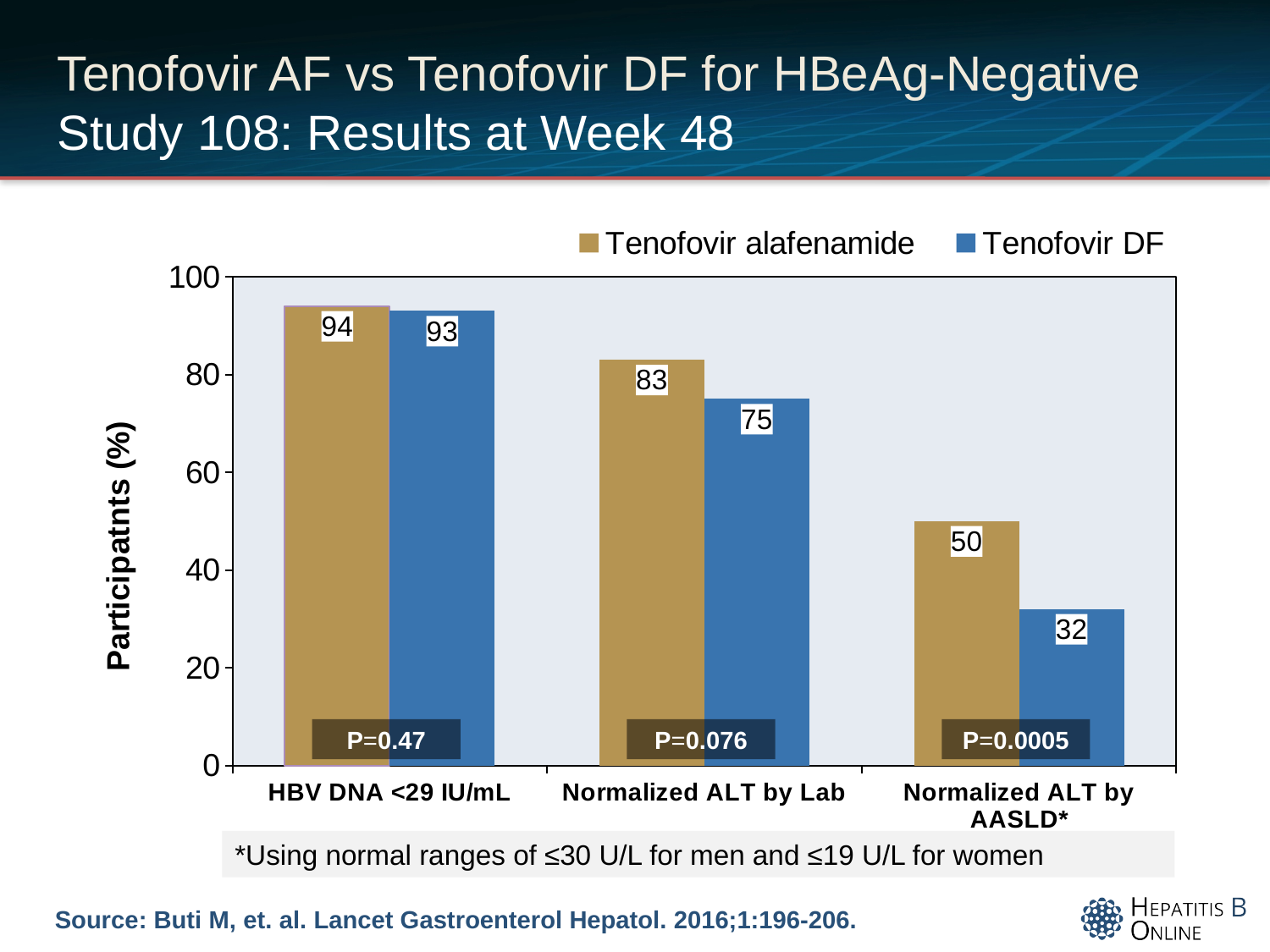
Which category has the highest value for Tenofovir DF? HBV DNA <29 IU/mL What is the difference between Tenofovir alafenamide and Tenofovir DF for Normalized ALT by AASLD*? 18 How many series does the legend list? 2 What P value is shown for the HBV DNA <29 IU/mL comparison? P=0.47 What percentage of participants on Tenofovir DF had normalized ALT by AASLD*? 32 What is the difference between Tenofovir alafenamide and Tenofovir DF for Normalized ALT by Lab? 8 Which category has the lowest value for Tenofovir alafenamide? Normalized ALT by AASLD* What percentage of participants on Tenofovir alafenamide achieved HBV DNA <29 IU/mL? 94 Which series has the larger value for Normalized ALT by Lab, Tenofovir alafenamide or Tenofovir DF? Tenofovir alafenamide What kind of chart is shown on the slide? Bar chart How many categories are shown on the x axis? 3 What is the value for Tenofovir DF in the Normalized ALT by Lab category? 75